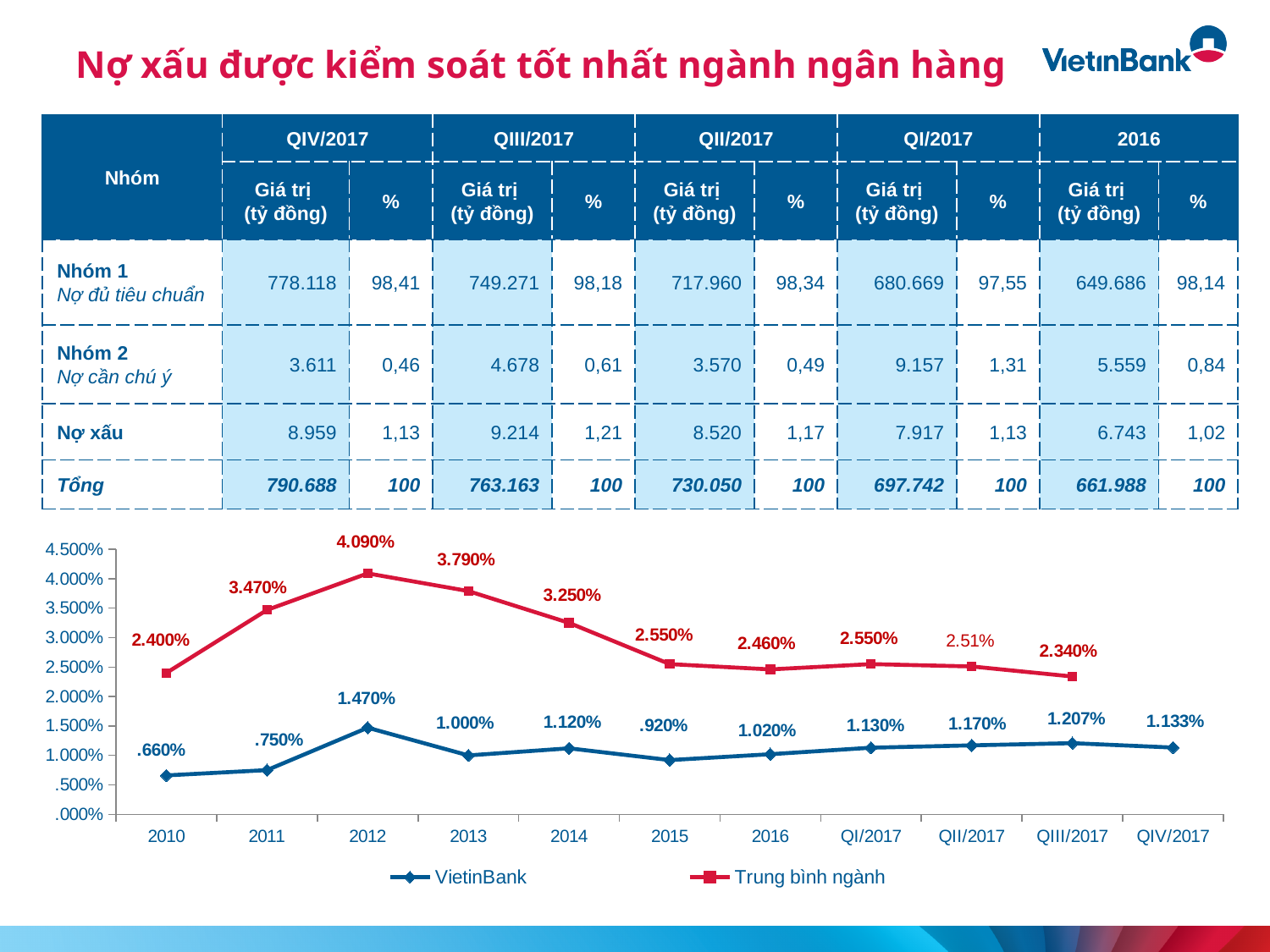
What kind of chart is shown at the bottom of the slide? line chart What is the Trung bình ngành value for 2010 in the chart? 2.400% What colour is the Trung bình ngành line in the chart? red What is the VietinBank value for QIV/2017 in the chart? 1.133% What is the difference between the Trung bình ngành and VietinBank values in 2012? 2.620% How many periods are shown on the x axis of the chart? 11 In which period does the Trung bình ngành series reach its highest value? 2012 What is the VietinBank value for 2012 in the chart? 1.470% Does the Trung bình ngành series rise or fall from 2012 to 2016? fall How many series does the chart legend list? 2 In which period is the VietinBank series at its lowest value? 2010 Which series has the larger value in 2015, VietinBank or Trung bình ngành? Trung bình ngành